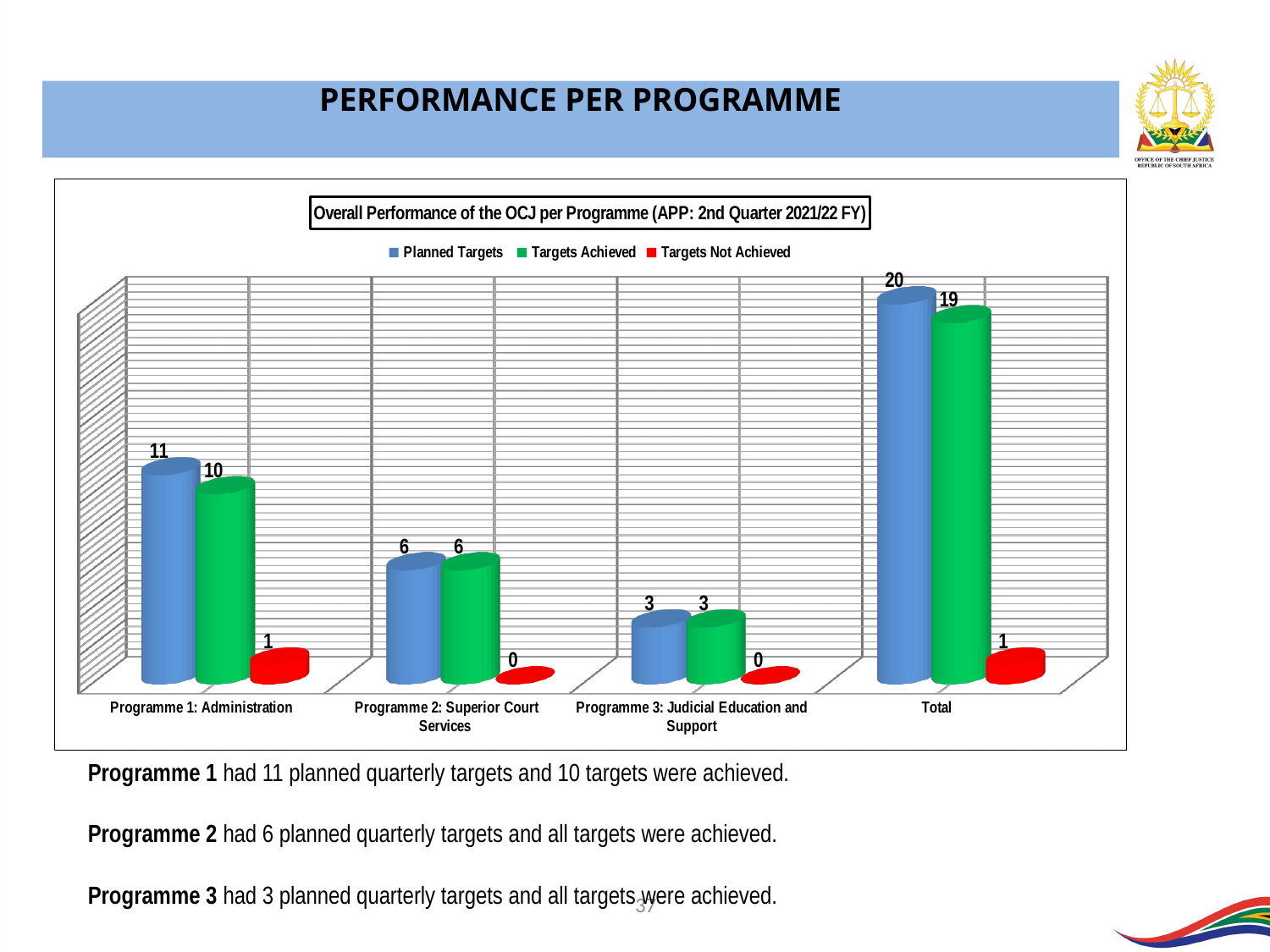
What is the value of Targets Not Achieved for Total? 1 Which category has the highest Planned Targets value? Total What is the value of Planned Targets for Programme 1: Administration? 11 What kind of chart is shown on the slide? Bar chart Which is larger: Planned Targets for Programme 1: Administration or Planned Targets for Programme 2: Superior Court Services? Programme 1: Administration How many categories are shown on the x axis? 4 What is the value of Targets Achieved for Programme 3: Judicial Education and Support? 3 What is the title of the chart? Overall Performance of the OCJ per Programme (APP: 2nd Quarter 2021/22 FY) Which programme has the lowest Targets Achieved value? Programme 3: Judicial Education and Support How many series does the legend list? 3 What colour represents Targets Not Achieved in the legend? Red What is the difference between Planned Targets and Targets Achieved for Total? 1